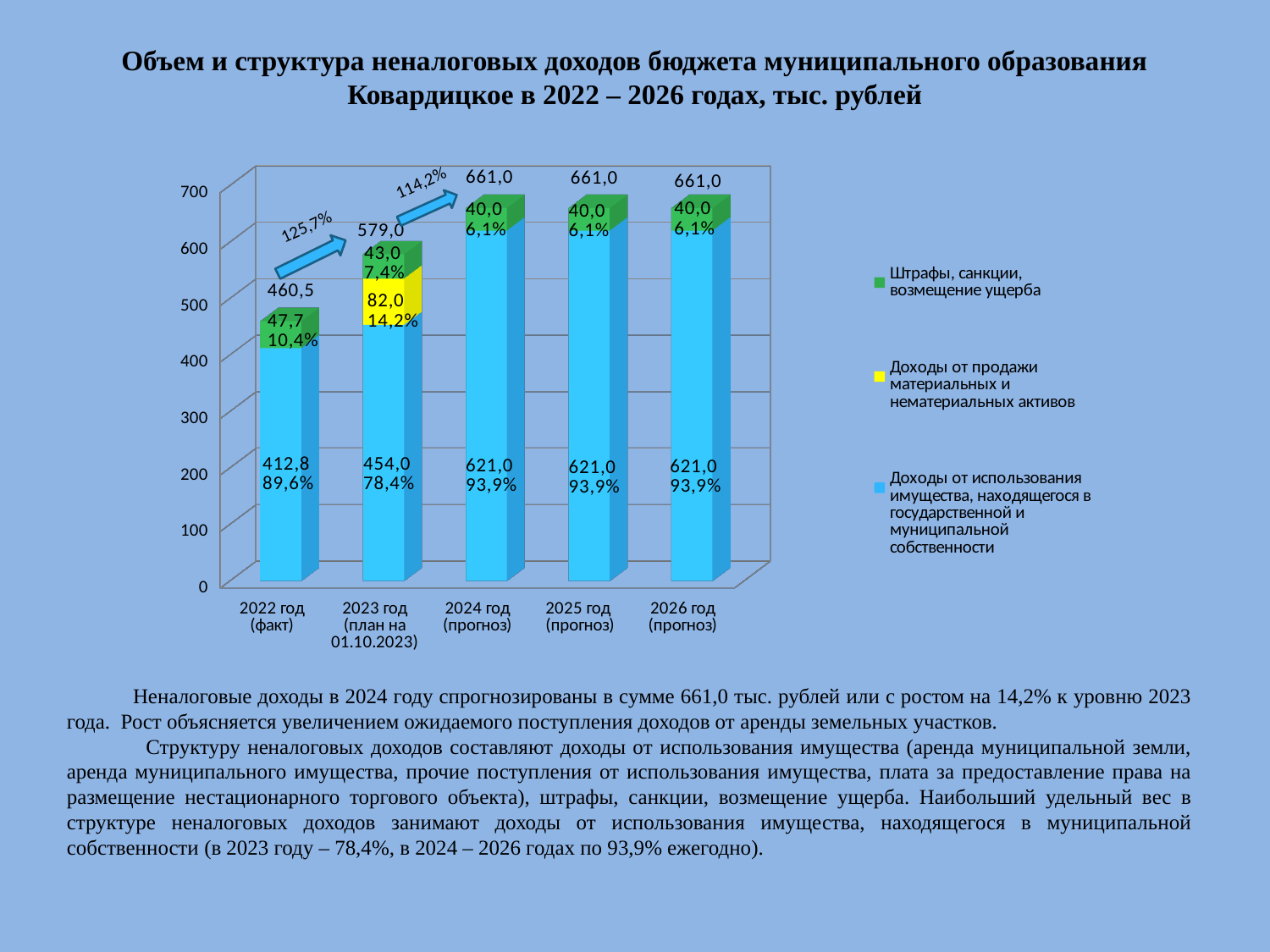
What is the total non-tax revenue shown for 2022 год (факт)? 460,5 What share of the 2024 год (прогноз) total does Доходы от использования имущества make up, as labelled on the chart? 93,9% What is the value of Штрафы, санкции, возмещение ущерба for 2022 год (факт)? 47,7 What growth percentage is shown on the arrow between 2023 год and 2024 год? 114,2% Is the value of Доходы от использования имущества larger in 2023 год or in 2024 год? 2024 год What is the difference between the total for 2024 год (прогноз) and the total for 2023 год? 82,0 What is the value of Доходы от использования имущества for 2023 год (план на 01.10.2023)? 454,0 What is the value of Доходы от продажи материальных и нематериальных активов for 2023 год? 82,0 Which year has the lowest total non-tax revenue? 2022 год (факт) How many year categories are shown on the x axis? 5 How many series does the legend list? 3 What kind of chart is shown on the slide? Stacked bar chart